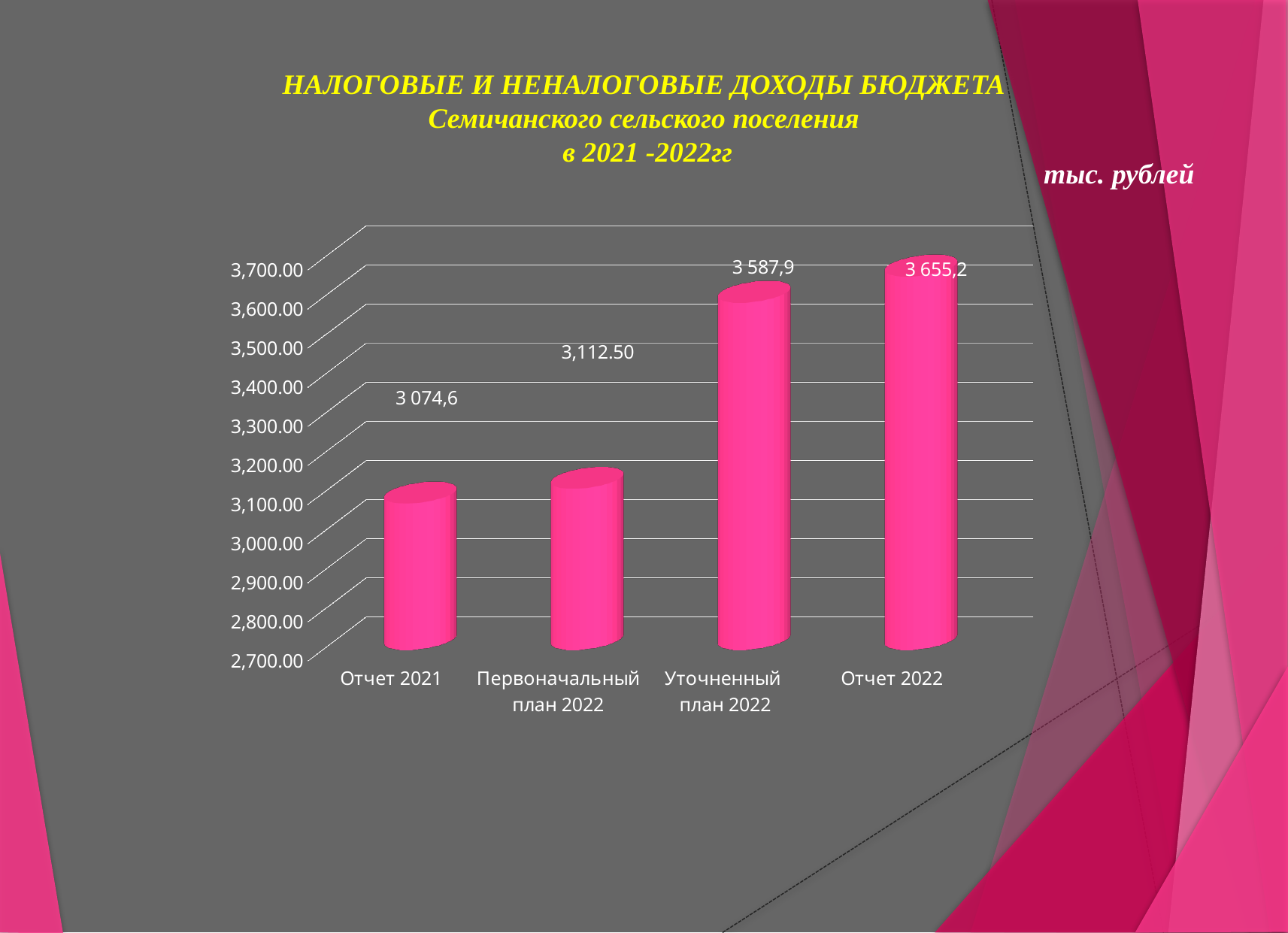
What is the difference between the values for Отчет 2022 and Уточненный план 2022? 67,3 Which category has the highest value? Отчет 2022 How many categories are plotted on the chart? 4 What type of chart is shown on the slide? bar chart What is the value for Уточненный план 2022? 3 587,9 What is the value for Первоначальный план 2022? 3,112.50 Is the value for Первоначальный план 2022 greater or less than 3,200.00? less Do the values rise or fall from left to right along the x axis? rise Which category has the lowest value? Отчет 2021 Which is larger, the value for Уточненный план 2022 or the value for Первоначальный план 2022? Уточненный план 2022 What is the value for Отчет 2021? 3 074,6 What is the value for Отчет 2022? 3 655,2